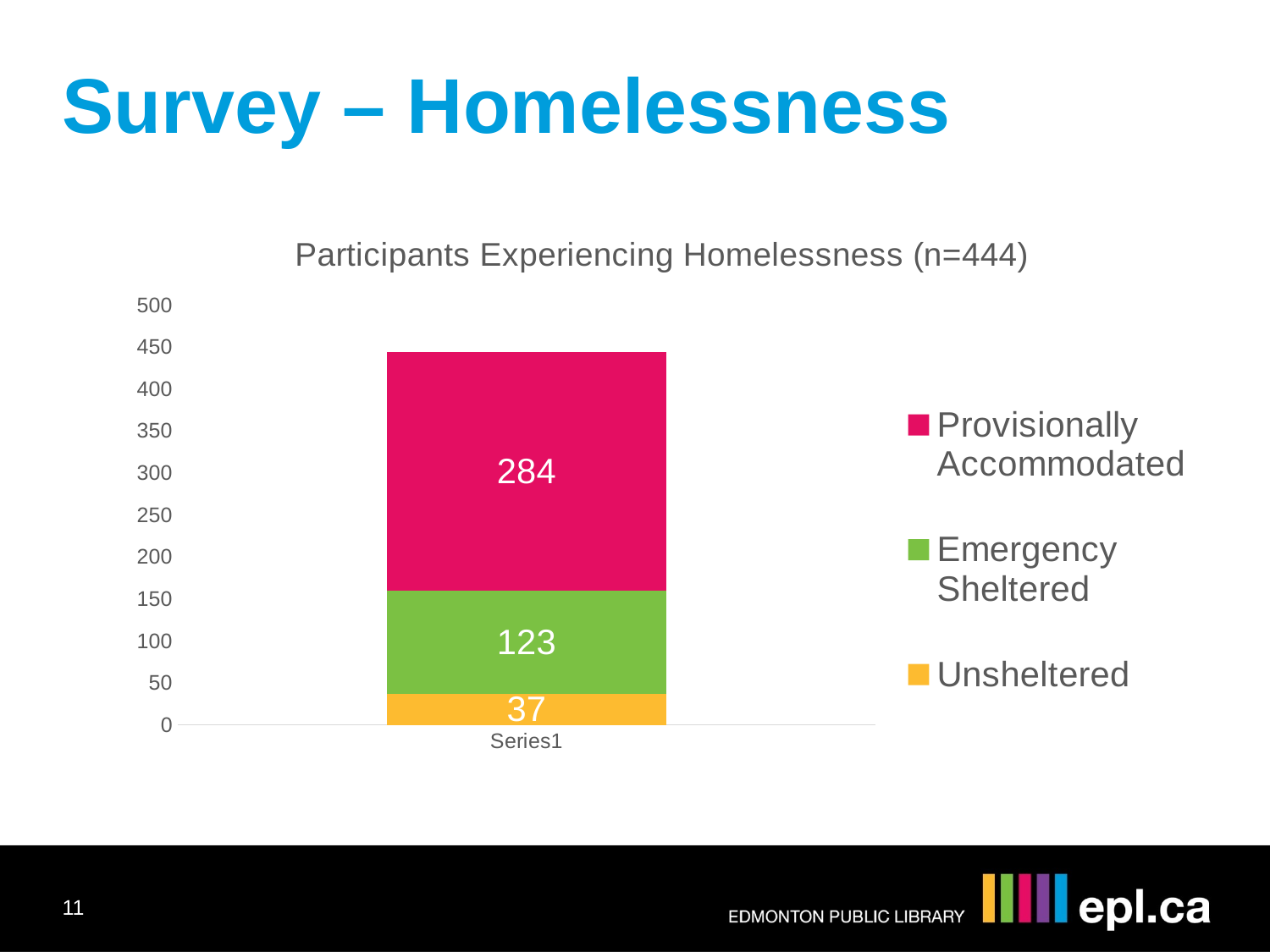
What kind of chart is shown on the slide? Stacked bar chart What is the title of the chart? Participants Experiencing Homelessness (n=444) Is the total height of the stacked bar greater or less than 400? greater What is the value for Unsheltered? 37 What is the difference between the Provisionally Accommodated and Emergency Sheltered values? 161 Which is larger, Emergency Sheltered or Unsheltered? Emergency Sheltered How many series does the legend list? 3 What is the value for Provisionally Accommodated? 284 What is the total of the stacked bar? 444 Which segment of the stacked bar is the smallest? Unsheltered Which segment of the stacked bar is the largest? Provisionally Accommodated What is the value for Emergency Sheltered? 123